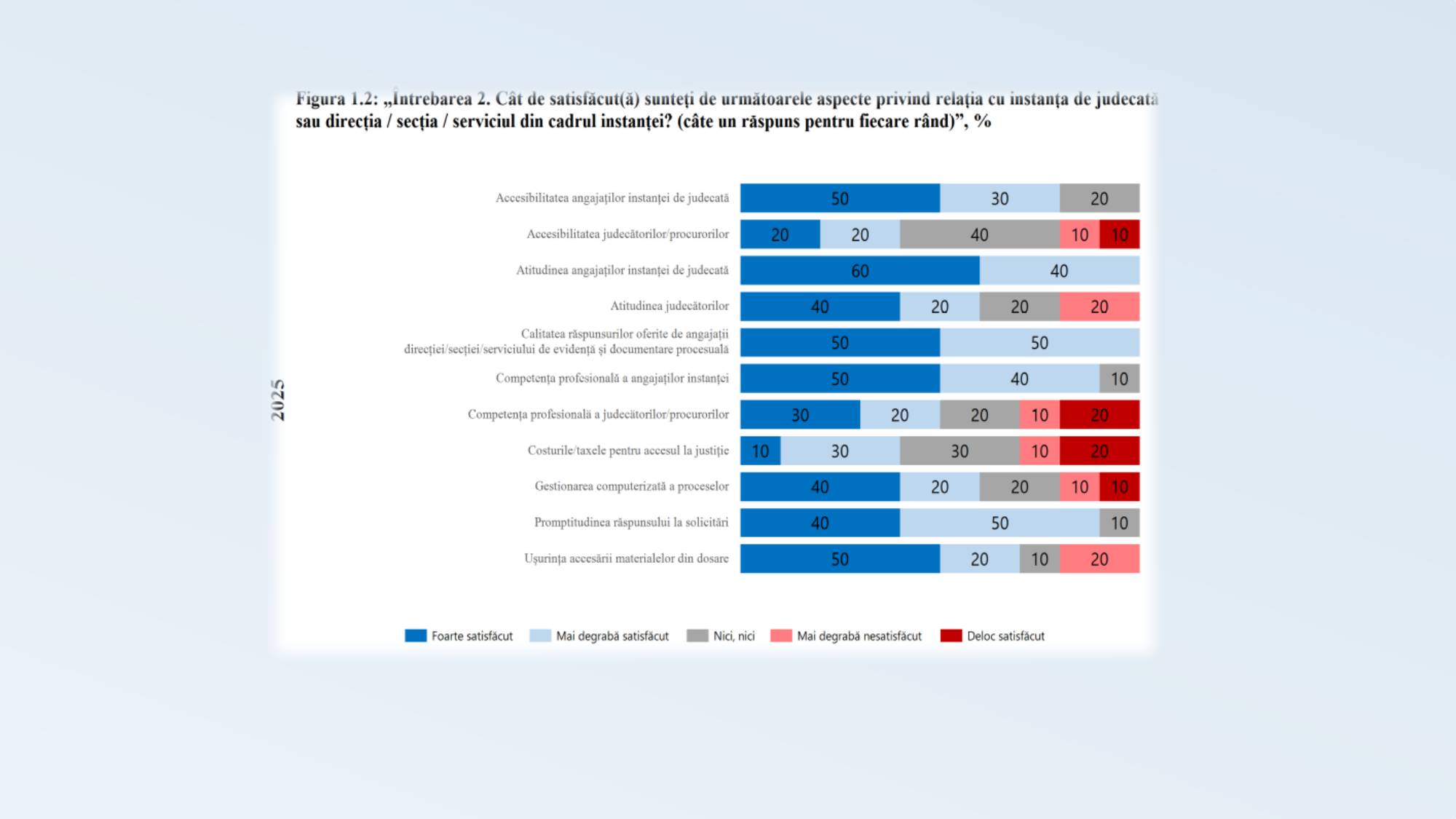
What is the 'Mai degrabă satisfăcut' value for 'Promptitudinea răspunsului la solicitări'? 50 What is the 'Nici, nici' value for 'Accesibilitatea judecătorilor/procurorilor'? 40 What is the 'Foarte satisfăcut' value for 'Atitudinea angajaților instanței de judecată'? 60 How many series does the legend list? 5 What type of chart is shown on the slide? Stacked bar chart How many categories (rows) are plotted in the chart? 11 Which legend entry is shown in dark red? Deloc satisfăcut Which is larger: the 'Mai degrabă nesatisfăcut' value for 'Atitudinea judecătorilor' or for 'Gestionarea computerizată a proceselor'? Atitudinea judecătorilor What is the difference between the 'Foarte satisfăcut' values for 'Ușurința accesării materialelor din dosare' and 'Competența profesională a judecătorilor/procurorilor'? 20 Which category has the highest 'Foarte satisfăcut' value? Atitudinea angajaților instanței de judecată What is the 'Deloc satisfăcut' value for 'Costurile/taxele pentru accesul la justiție'? 20 Which category has the lowest 'Foarte satisfăcut' value? Costurile/taxele pentru accesul la justiție